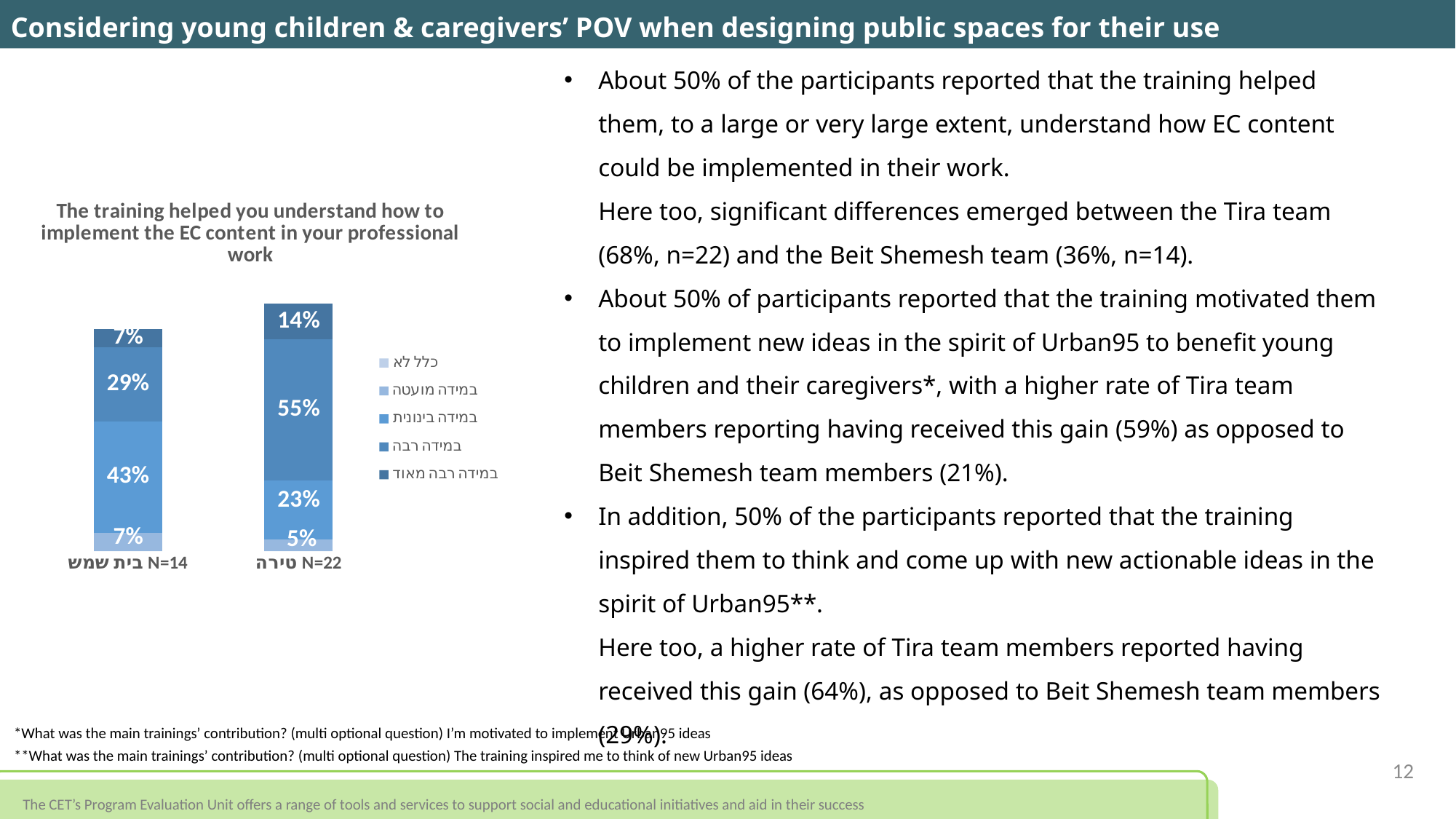
What is the value of the topmost segment of the בית שמש N=14 bar? 7% How many bars are plotted in the chart? 2 What sample size (N) is shown for the בית שמש bar? N=14 What is the title of the chart? The training helped you understand how to implement the EC content in your professional work What is the value of the second segment from the bottom in the בית שמש N=14 bar? 43% What is the difference between the second-from-top segment of the טירה bar (55%) and the second-from-top segment of the בית שמש bar (29%)? 26 percentage points What is the value of the largest segment in the טירה N=22 bar? 55% What type of chart is shown on the slide? Stacked bar chart What is the value of the bottom segment of the טירה N=22 bar? 5% Which bar has the larger topmost segment, בית שמש N=14 or טירה N=22? טירה N=22 How many series does the chart legend list? 5 What is the value of the topmost segment of the טירה N=22 bar? 14%